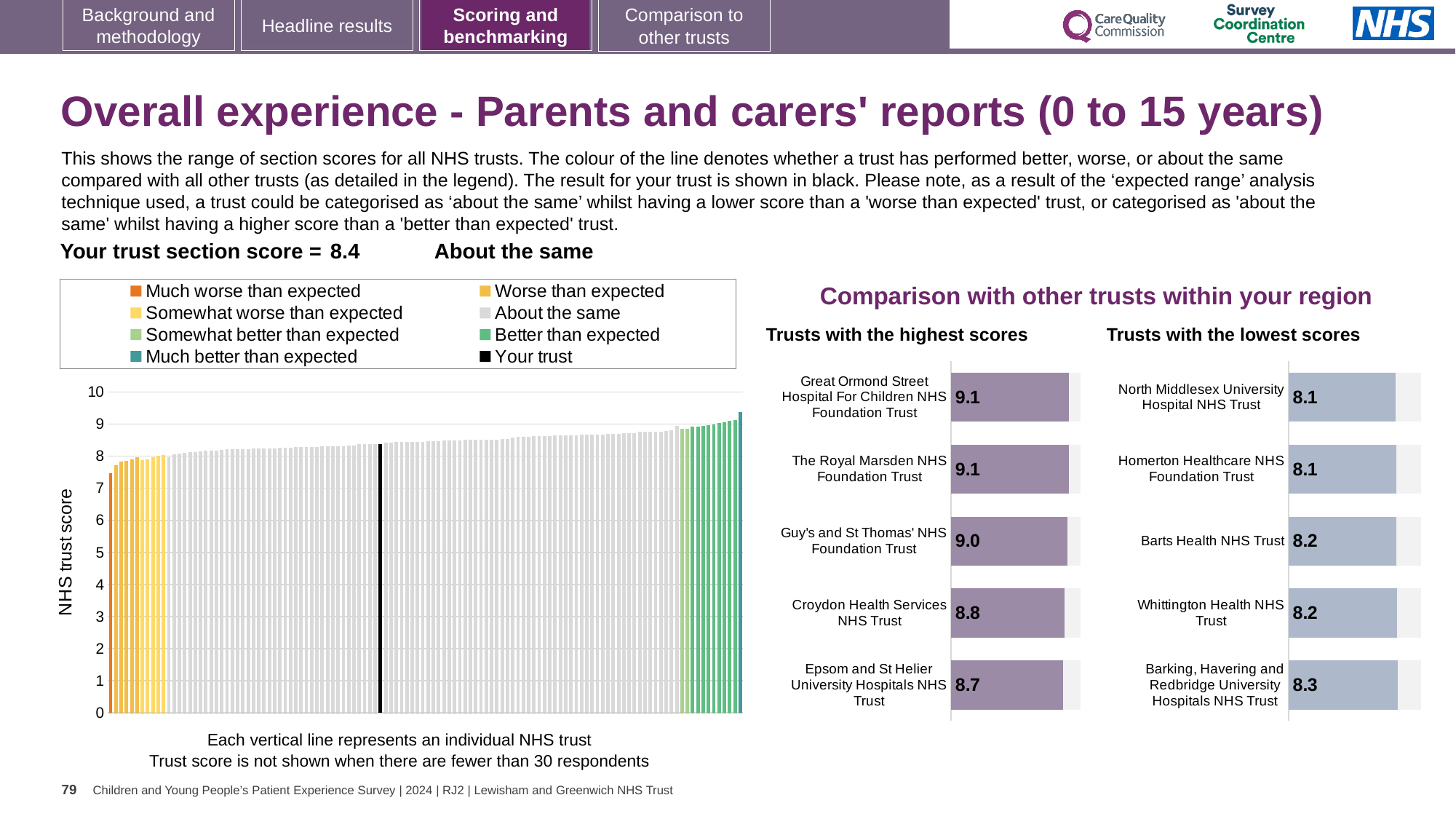
In the 'Trusts with the highest scores' chart, what is the score for Epsom and St Helier University Hospitals NHS Trust? 8.7 In the NHS trust score chart on the left, do the trust scores rise or fall from left to right along the x axis? Rise How many entries does the legend of the NHS trust score chart on the left list? 8 In the 'Trusts with the lowest scores' chart, what is the score for Barts Health NHS Trust? 8.2 In the 'Trusts with the highest scores' chart, which has the higher score: Guy's and St Thomas' NHS Foundation Trust or Croydon Health Services NHS Trust? Guy's and St Thomas' NHS Foundation Trust In the 'Trusts with the highest scores' chart, what is the score for Croydon Health Services NHS Trust? 8.8 In the 'Trusts with the highest scores' chart, which trust has the lowest score? Epsom and St Helier University Hospitals NHS Trust In the 'Trusts with the lowest scores' chart, what is the difference between the scores of Barking, Havering and Redbridge University Hospitals NHS Trust and North Middlesex University Hospital NHS Trust? 0.2 In the 'Trusts with the highest scores' chart, what is the difference between the scores of Great Ormond Street Hospital For Children NHS Foundation Trust and Epsom and St Helier University Hospitals NHS Trust? 0.4 What kind of chart is the NHS trust score chart on the left of the slide? Bar chart In the 'Trusts with the lowest scores' chart, which trust has the highest score? Barking, Havering and Redbridge University Hospitals NHS Trust How many trusts are shown in the 'Trusts with the highest scores' chart? 5